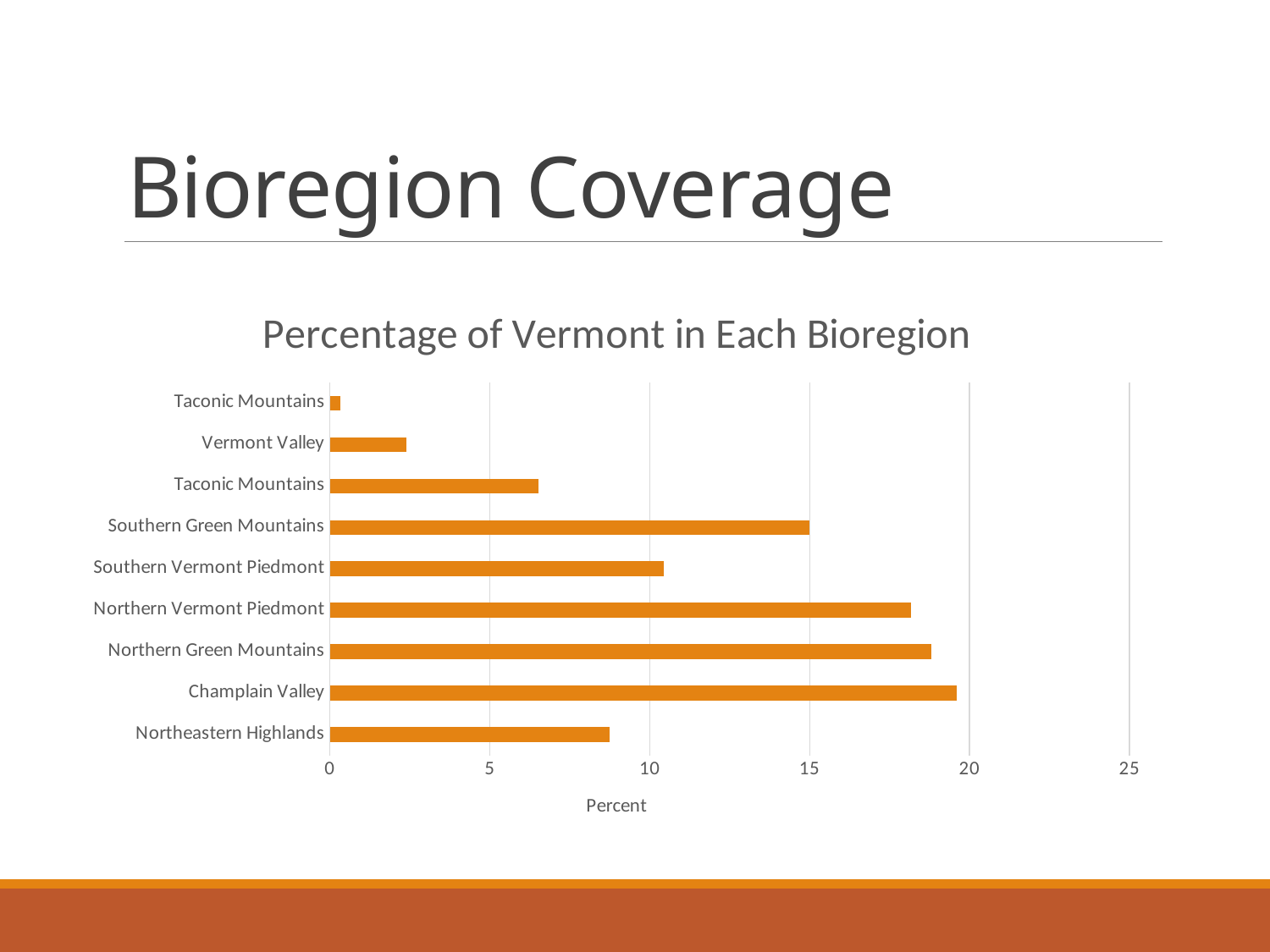
Is the value for Vermont Valley greater or less than 5? less What is the title of the chart? Percentage of Vermont in Each Bioregion How many bioregion bars are plotted in the chart? 9 Which is larger, the value for Southern Green Mountains or the value for Southern Vermont Piedmont? Southern Green Mountains Is the value for Champlain Valley greater or less than 20? less Which is larger, the value for Northern Green Mountains or the value for Northeastern Highlands? Northern Green Mountains Which bioregion has the lowest percentage of Vermont? Taconic Mountains What is the label on the horizontal axis of the chart? Percent Is the value for Northeastern Highlands greater or less than 10? less What kind of chart is shown on the slide? bar chart Which bioregion has the highest percentage of Vermont? Champlain Valley